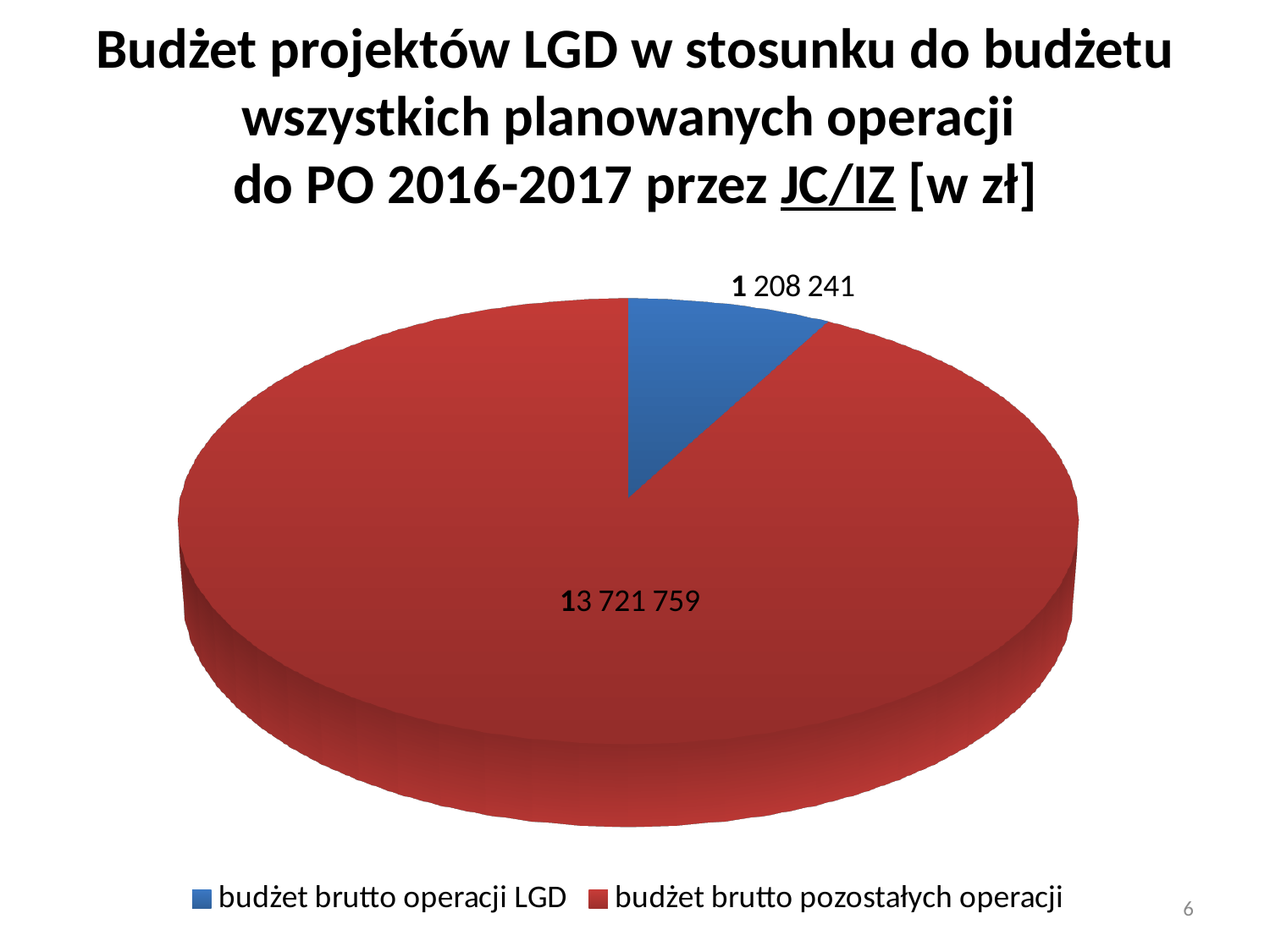
Which category has the smallest slice of the pie? budżet brutto operacji LGD What share of the pie does budżet brutto operacji LGD represent, to the nearest whole percent? 8% What is the total of the two slices in the pie chart? 14 930 000 What is the value for budżet brutto pozostałych operacji? 13 721 759 Which category has the largest slice of the pie? budżet brutto pozostałych operacji Which is larger: budżet brutto operacji LGD or budżet brutto pozostałych operacji? budżet brutto pozostałych operacji How many entries does the legend list? 2 What colour is the slice for budżet brutto operacji LGD? blue How many slices does the pie chart have? 2 What is the value for budżet brutto operacji LGD? 1 208 241 What kind of chart is shown on the slide? pie chart What is the difference between budżet brutto pozostałych operacji and budżet brutto operacji LGD? 12 513 518